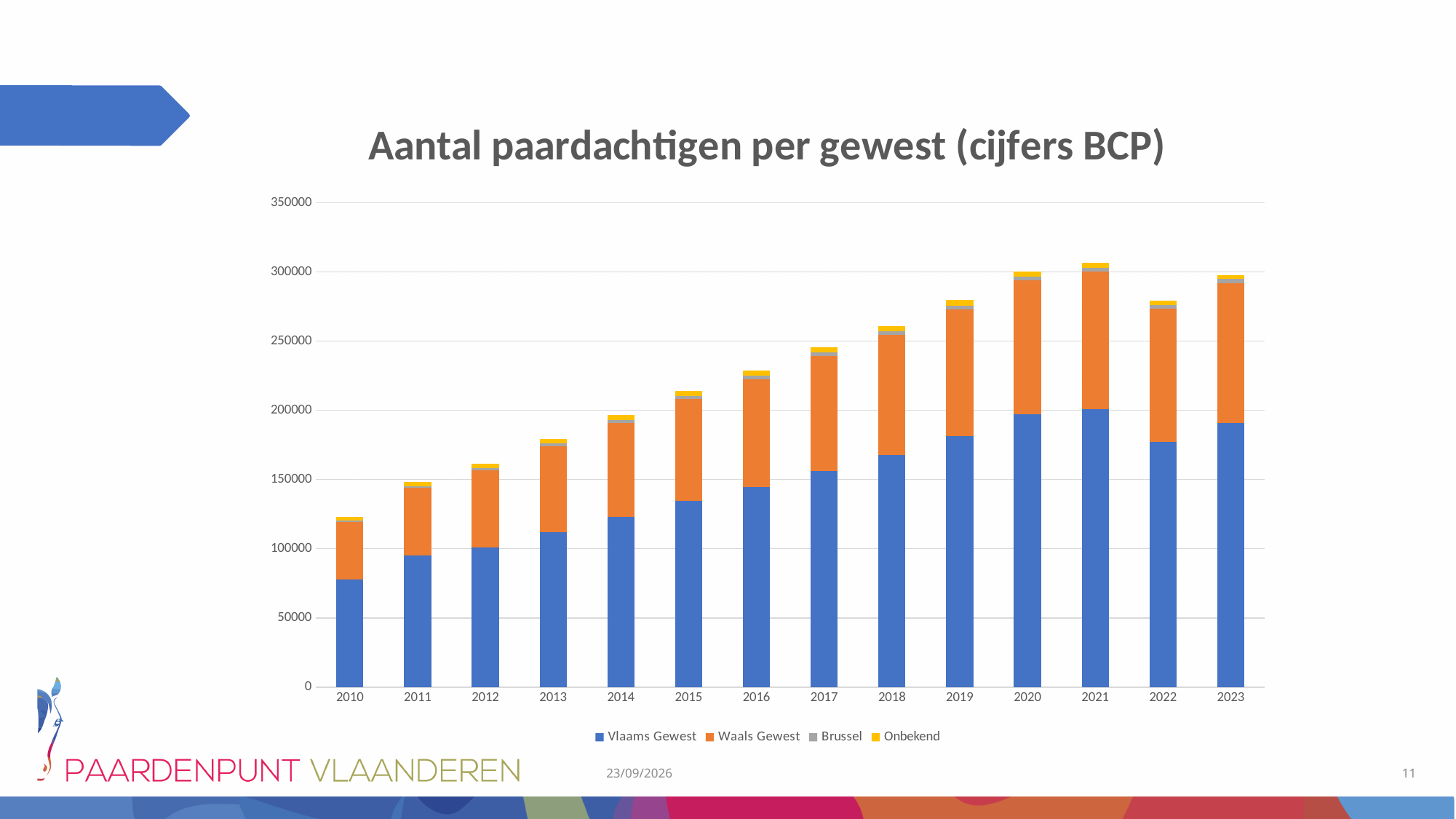
Is the total bar for 2023 larger or smaller than the total bar for 2022? larger Is the total bar for 2021 greater or less than 300000? greater How many series does the legend list? 4 Is the value for Vlaams Gewest in 2010 greater or less than 100000? less Which year has the lowest total number of paardachtigen? 2010 What kind of chart is shown on the slide? Stacked bar chart Is the total bar for 2010 greater or less than 150000? less Do the total values generally rise or fall from 2010 to 2021? rise Which year has the highest total number of paardachtigen? 2021 How many years are shown on the x axis of the chart? 14 Which year has the lowest value for Vlaams Gewest? 2010 What colour represents Waals Gewest in the chart? Orange